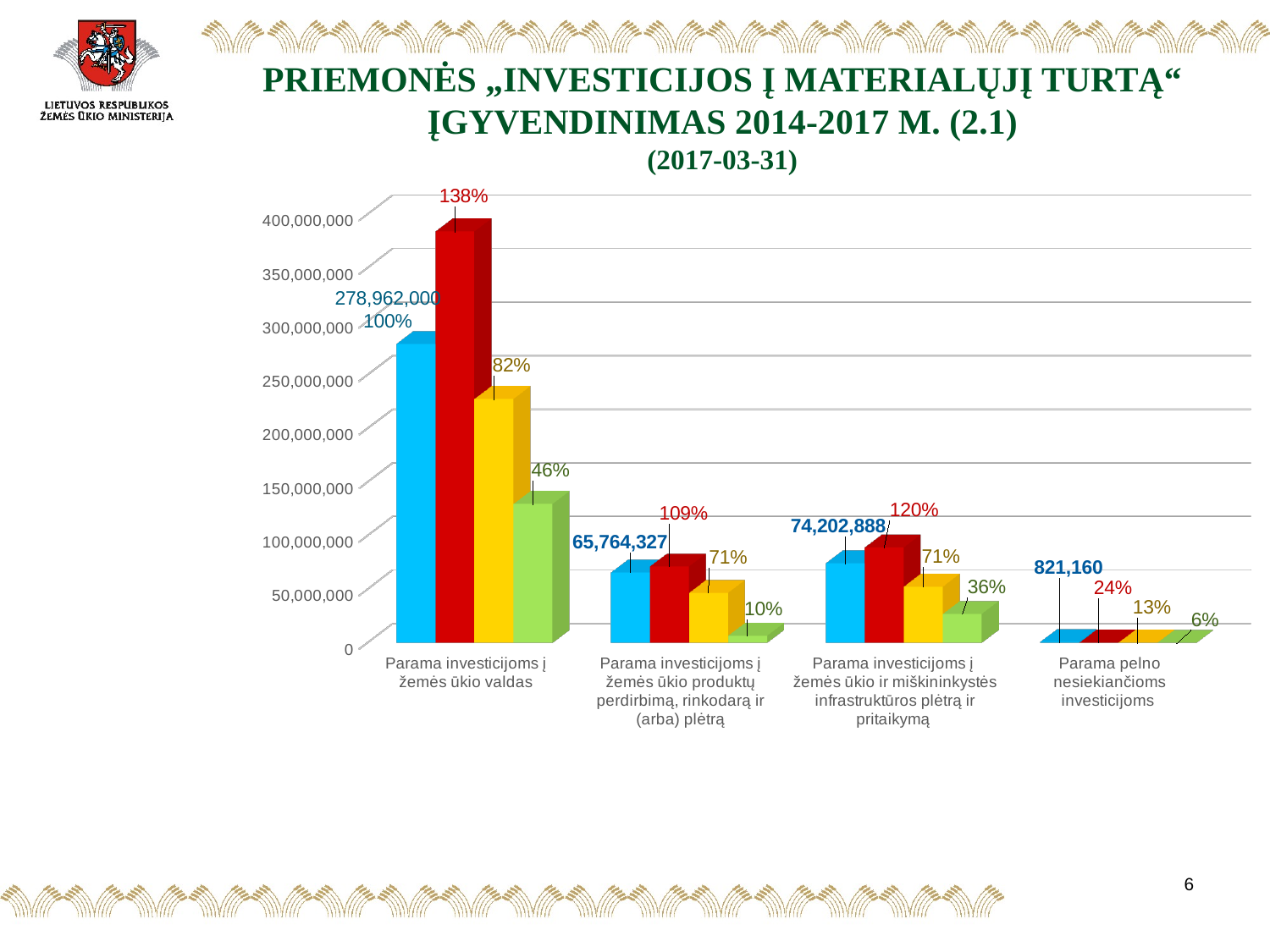
Which category has the highest blue bar value? Parama investicijoms į žemės ūkio valdas Which category has the lowest blue bar value? Parama pelno nesiekiančioms investicijoms Is the red bar for "Parama investicijoms į žemės ūkio valdas" greater or less than 350,000,000? greater Which blue bar value is larger: "Parama investicijoms į žemės ūkio produktų perdirbimą, rinkodarą ir (arba) plėtrą" or "Parama investicijoms į žemės ūkio ir miškininkystės infrastruktūros plėtrą ir pritaikymą"? Parama investicijoms į žemės ūkio ir miškininkystės infrastruktūros plėtrą ir pritaikymą What percentage is printed on the green bar for "Parama investicijoms į žemės ūkio produktų perdirbimą, rinkodarą ir (arba) plėtrą"? 10% How many categories are shown on the x axis of the chart? 4 What value is printed on the blue bar for "Parama investicijoms į žemės ūkio produktų perdirbimą, rinkodarą ir (arba) plėtrą"? 65,764,327 What kind of chart is shown on the slide? bar chart What value is printed on the blue bar for "Parama pelno nesiekiančioms investicijoms"? 821,160 What value is printed on the blue bar for "Parama investicijoms į žemės ūkio valdas"? 278,962,000 What value is printed on the blue bar for "Parama investicijoms į žemės ūkio ir miškininkystės infrastruktūros plėtrą ir pritaikymą"? 74,202,888 What percentage is printed on the red bar for "Parama investicijoms į žemės ūkio valdas"? 138%